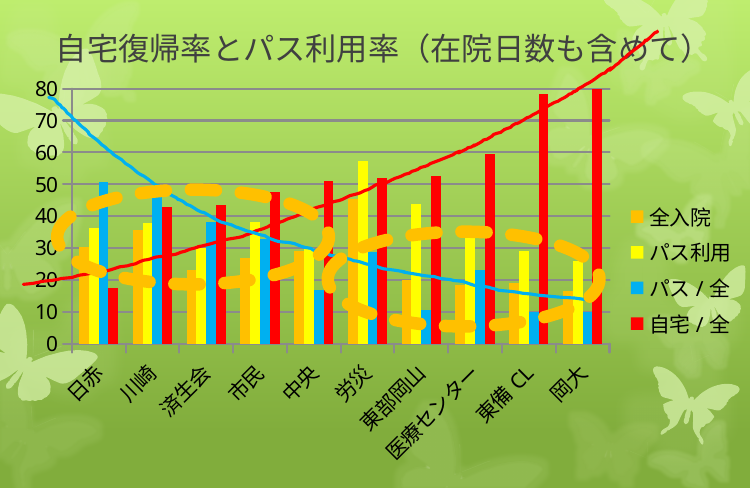
How many categories (hospitals) are shown on the x axis? 10 Is the value for パス / 全 at 日赤 greater or less than 40? greater Which category has the lowest value for 自宅 / 全? 日赤 Is the value for パス / 全 at 東部岡山 greater or less than 20? less What is the title of the chart? 自宅復帰率とパス利用率（在院日数も含めて） Is the value for 自宅 / 全 at 岡大 greater or less than 70? greater Which category has the highest value for パス / 全? 日赤 What kind of chart is shown on the slide? bar chart At 岡大, which is larger: 自宅 / 全 or パス / 全? 自宅 / 全 Which category has the highest value for パス利用? 労災 How many series does the legend list? 4 Do the 自宅 / 全 values generally rise or fall from left to right along the x axis? rise